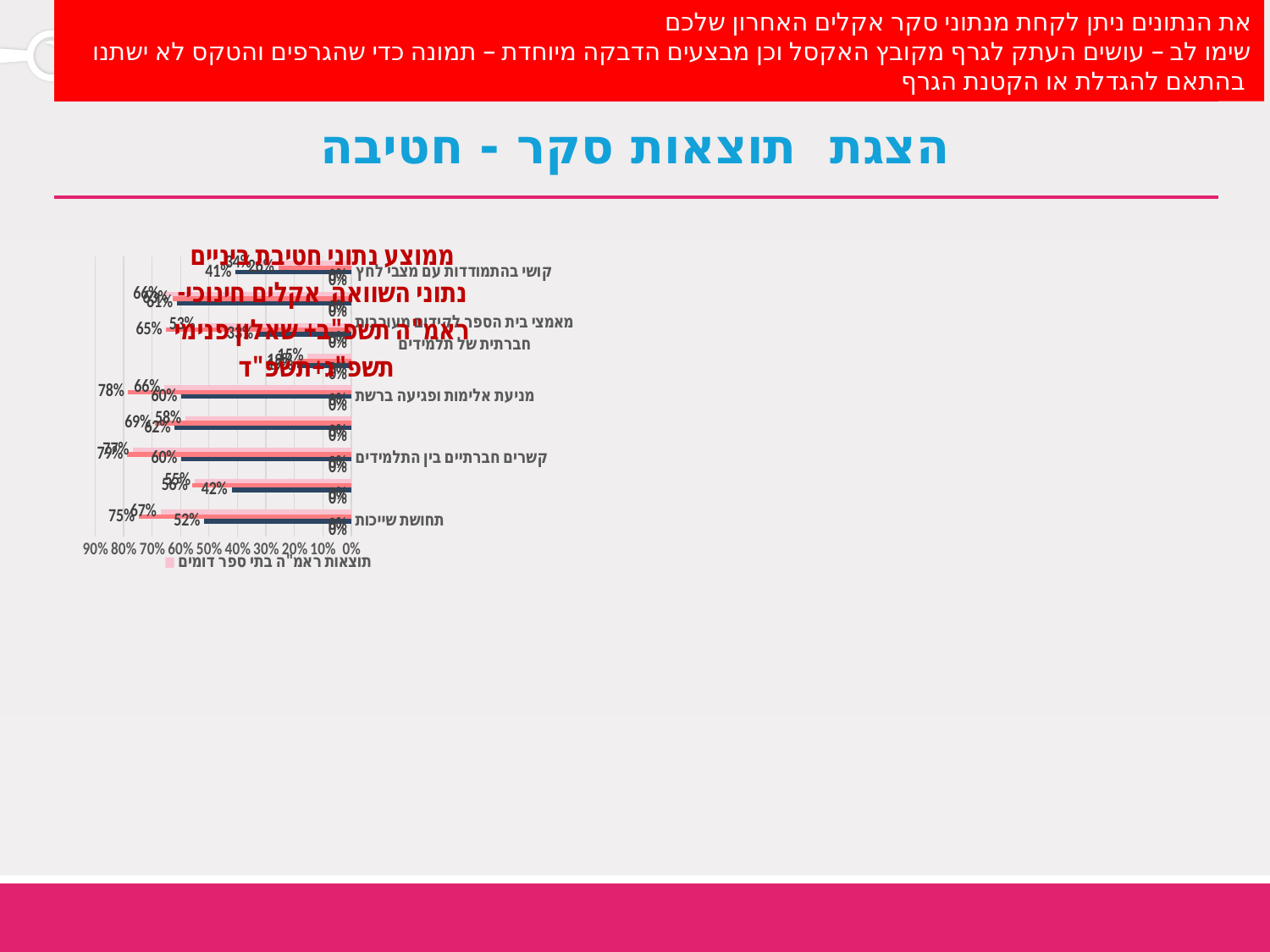
Which category has the longer longest bar: מניעת אלימות ופגיעה ברשת or קושי בהתמודדות עם מצבי לחץ? מניעת אלימות ופגיעה ברשת What kind of chart is shown on the slide? bar chart What is the largest value labelled for the category מניעת אלימות ופגיעה ברשת? 78% What is the highest value shown on the percentage axis of the chart? 90% What is the smallest non-zero value labelled for the category מניעת אלימות ופגיעה ברשת? 60% What is the difference between the largest value (75%) and the smallest non-zero value (52%) labelled for תחושת שייכות? 23 percentage points Is the longest bar for קושי בהתמודדות עם מצבי לחץ greater or less than 50%? less What legend entry is shown below the chart? תוצאות ראמ"ה בתי ספר דומים Is the longest bar for מניעת אלימות ופגיעה ברשת greater or less than 70%? greater What is the smallest non-zero value labelled for the category תחושת שייכות? 52% What is the largest value labelled for the category תחושת שייכות? 75%